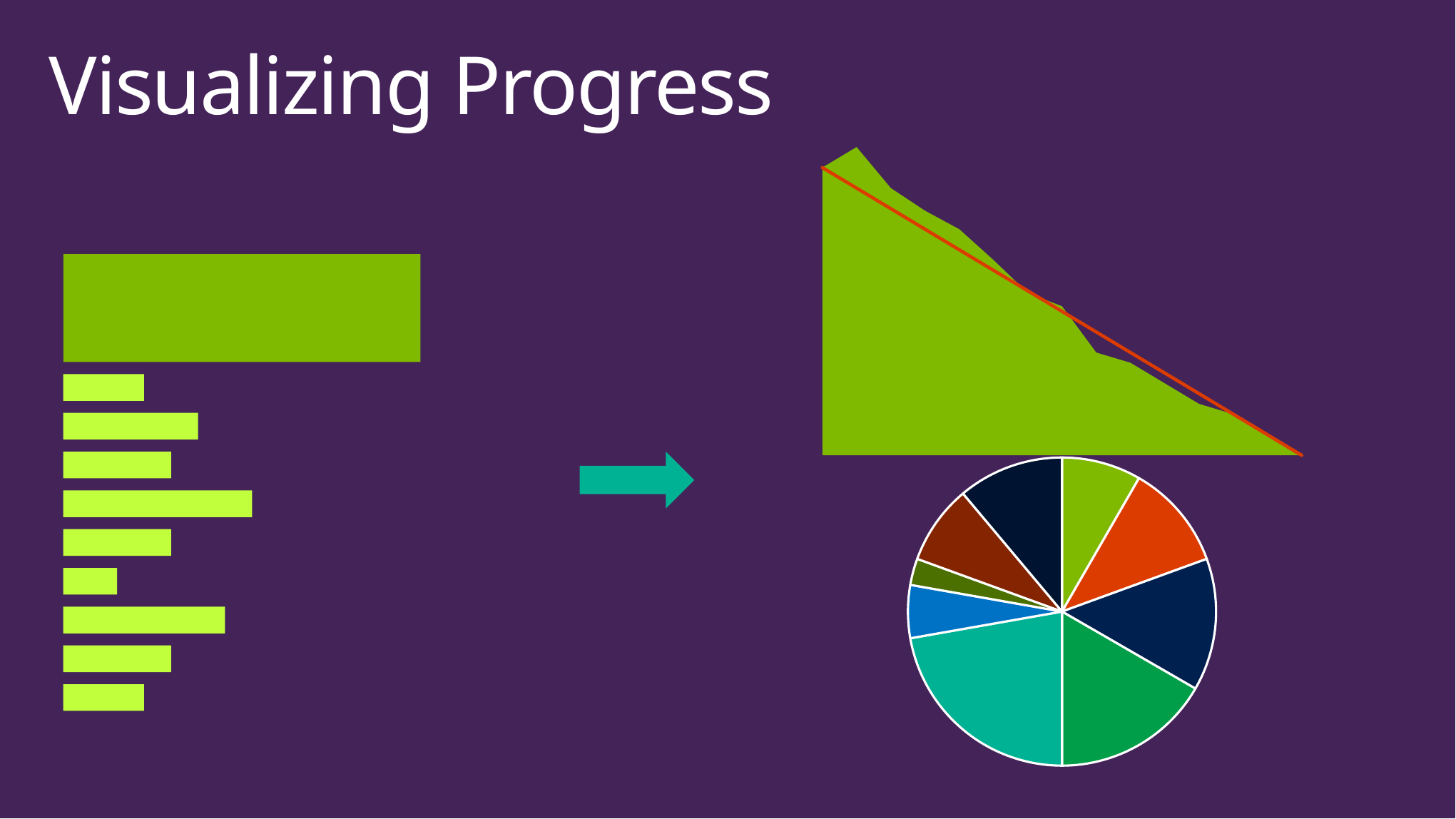
In the bar chart on the left, how many thin bars are there below the large bar? 9 What colour are the bars in the bar chart on the left? green In the bar chart on the left, which of the thin bars is the longest? the fourth from the top In the bar chart on the left, which is longer, the fourth thin bar from the top or the sixth thin bar from the top? the fourth What kind of chart is shown at the top right of the slide? area chart What kind of chart is shown on the left side of the slide? bar chart In the bar chart on the left, which of the thin bars is the shortest? the sixth from the top How many slices does the pie chart at the bottom right have? 9 In the pie chart at the bottom right, which colour slice is the largest? teal In the area chart at the top right, do the values rise or fall from left to right? fall What kind of chart is shown at the bottom right of the slide? pie chart What colour is the straight trend line drawn over the area chart at the top right? red